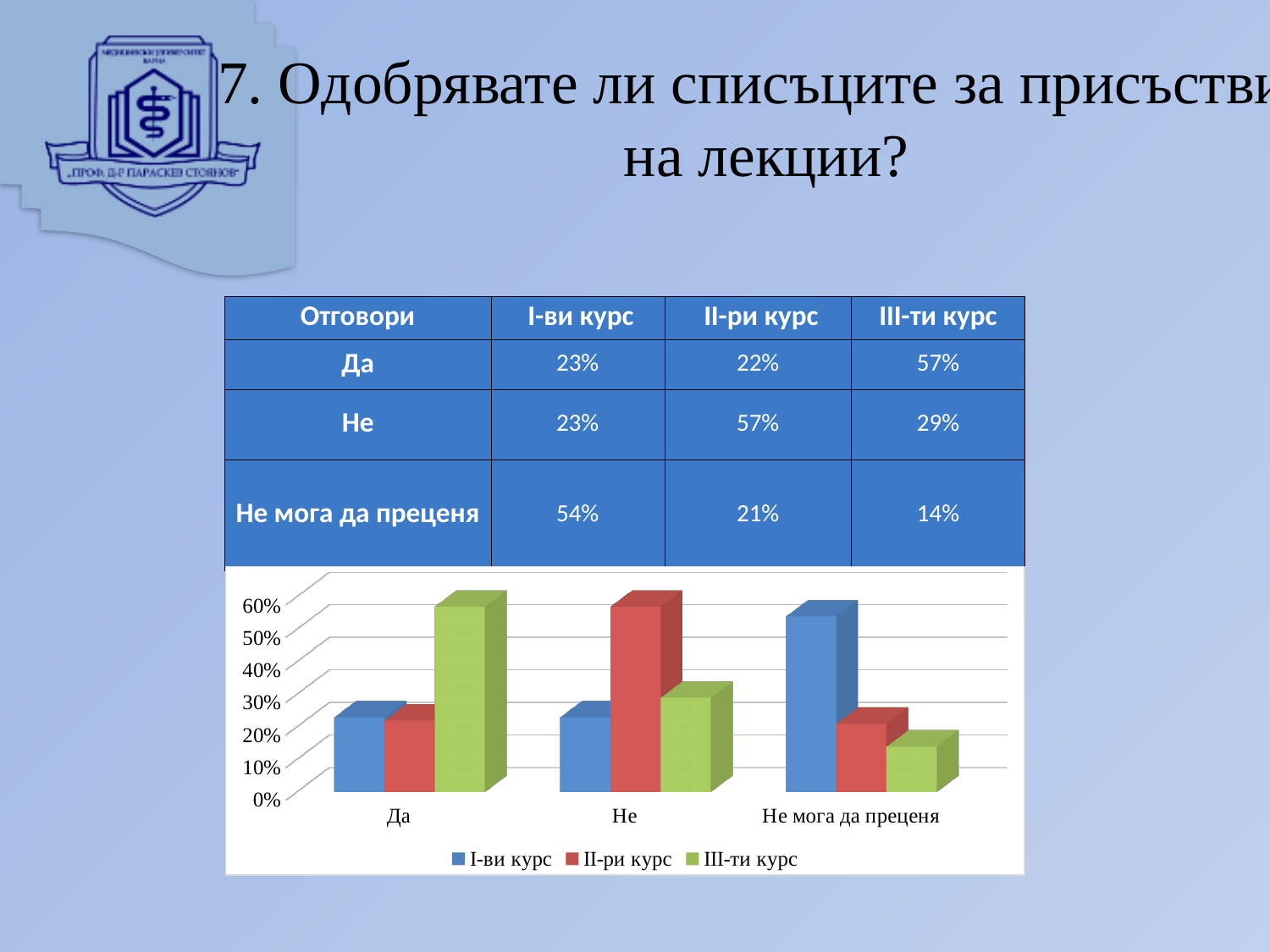
Which series has the lowest value in the Не мога да преценя category? III-ти курс Which is larger: the I-ви курс value for Не мога да преценя or the II-ри курс value for Не мога да преценя? I-ви курс What kind of chart is shown on the slide? bar chart What is the value for II-ри курс in the Не category? 57% What is the difference between the II-ри курс and III-ти курс values in the Не category? 28% How many categories are shown on the x axis of the chart? 3 What is the value for I-ви курс in the Не мога да преценя category? 54% Is the value for I-ви курс in the Не мога да преценя category greater or less than 50%? greater Which series has the highest value in the Да category? III-ти курс What colour are the bars for II-ри курс in the chart? red What is the value for III-ти курс in the Да category? 57% How many series does the chart legend list? 3